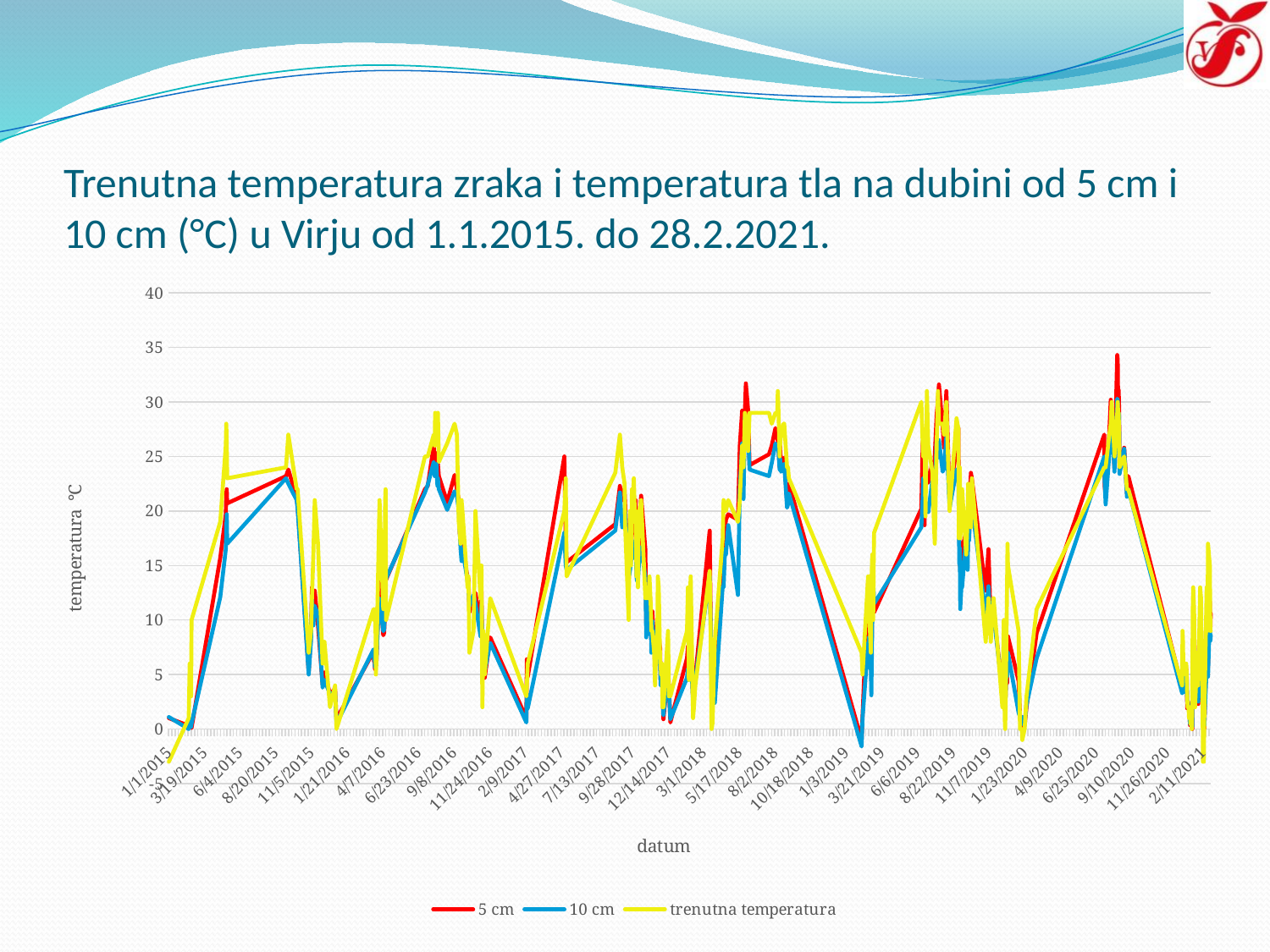
What is the highest value shown on the y axis? 40 Which colour is used for the 'trenutna temperatura' series? yellow What kind of chart is shown on the slide? line chart What is the label of the x axis? datum What is the last date shown on the x axis? 2/11/2021 Is the highest peak of the 5 cm series (around 9/10/2020) greater or less than 30? greater What is the label of the y axis? temperatura °C How many series does the legend list? 3 Is the value of the 'trenutna temperatura' series at 1/1/2015 greater or less than 0? less What is the lowest value shown on the y axis? -5 What is the first date shown on the x axis? 1/1/2015 What are the three series named in the legend? 5 cm, 10 cm, trenutna temperatura